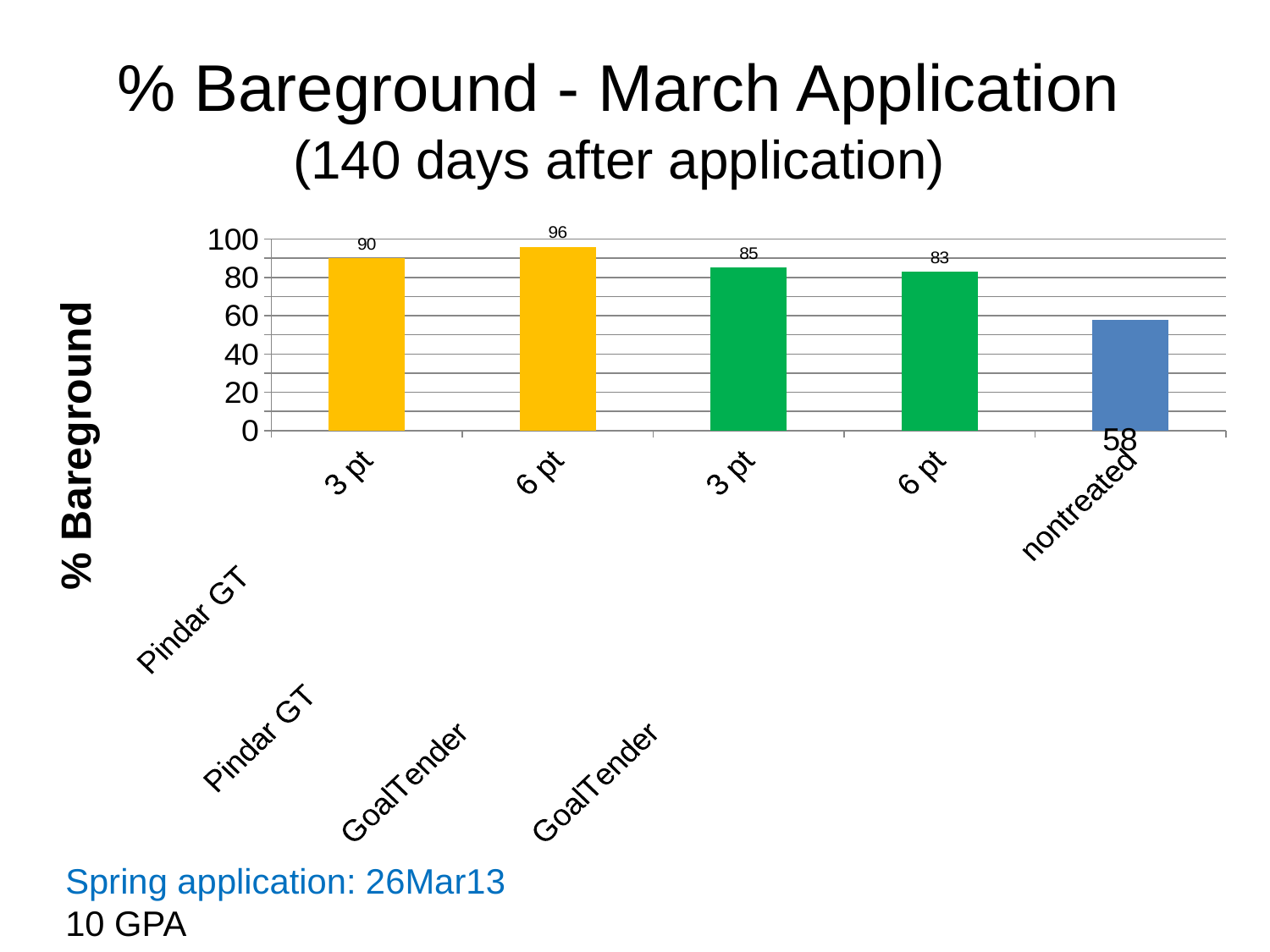
What is the % bareground value for the nontreated treatment? 58 How many bars are shown in the chart? 5 Which has a higher % bareground, GoalTender 6 pt or the nontreated treatment? GoalTender 6 pt What is the difference in % bareground between Pindar GT 3 pt and GoalTender 3 pt? 5 What is the % bareground value for GoalTender at 3 pt? 85 What is the label on the vertical axis of the chart? % Bareground What is the difference in % bareground between Pindar GT 6 pt and the nontreated treatment? 38 Which treatment has the highest % bareground? Pindar GT 6 pt Which treatment has the lowest % bareground? nontreated What is the % bareground value for Pindar GT at 3 pt? 90 What type of chart is shown on the slide? bar chart What is the % bareground value for Pindar GT at 6 pt? 96